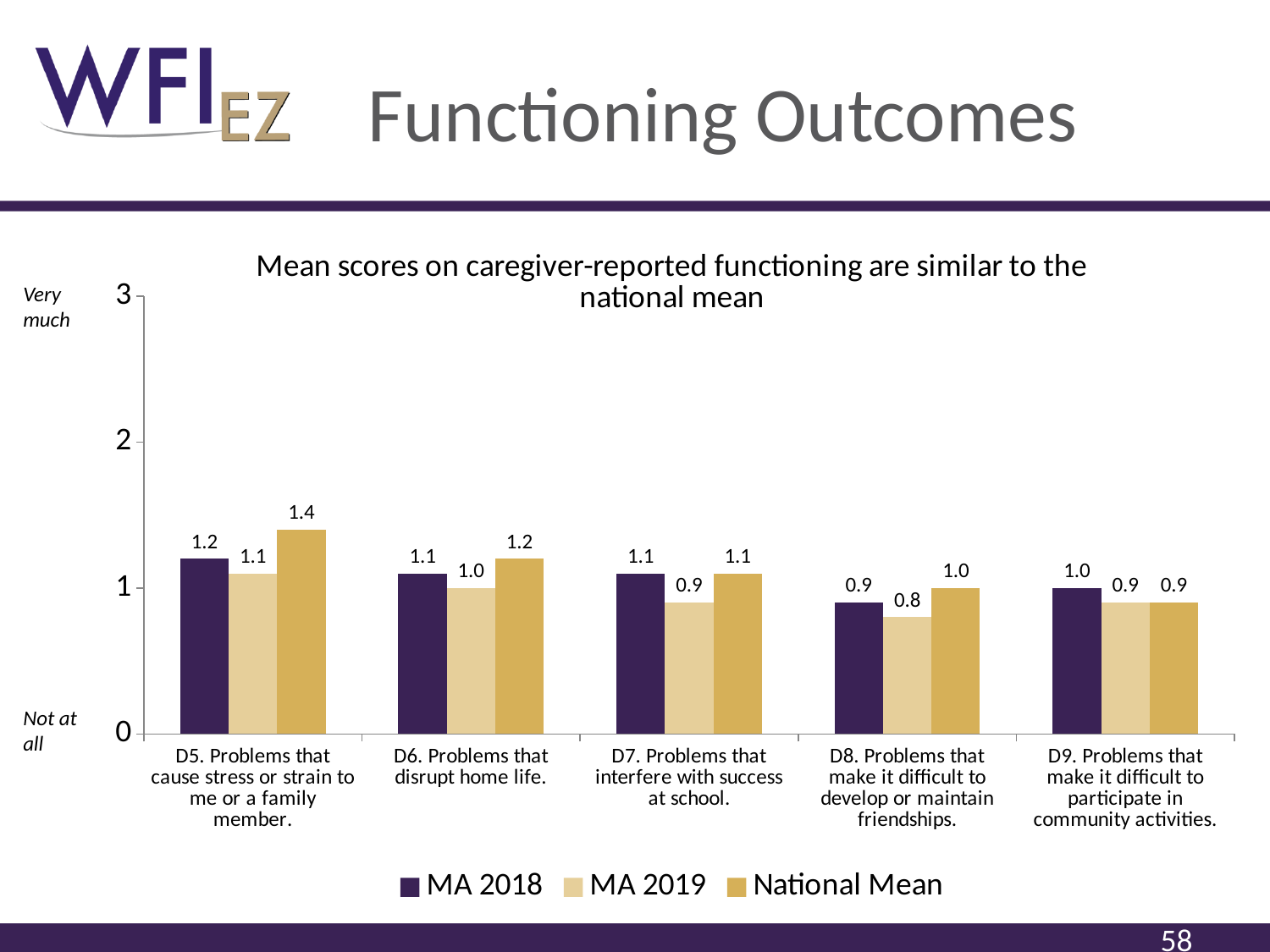
Which category has the highest National Mean value? D5. Problems that cause stress or strain to me or a family member. What is the difference between the National Mean and MA 2019 values for D5. Problems that cause stress or strain to me or a family member? 0.3 What is the MA 2019 value for D8. Problems that make it difficult to develop or maintain friendships? 0.8 How many categories are shown on the x axis? 5 What is the title of the chart? Mean scores on caregiver-reported functioning are similar to the national mean How many series does the legend list? 3 What label appears at the top of the y axis next to the value 3? Very much For D7. Problems that interfere with success at school, which is larger: the MA 2018 value or the MA 2019 value? MA 2018 Which category has the lowest MA 2019 value? D8. Problems that make it difficult to develop or maintain friendships. What kind of chart is shown on the slide? Bar chart What is the MA 2018 value for D5. Problems that cause stress or strain to me or a family member? 1.2 What is the National Mean value for D6. Problems that disrupt home life? 1.2